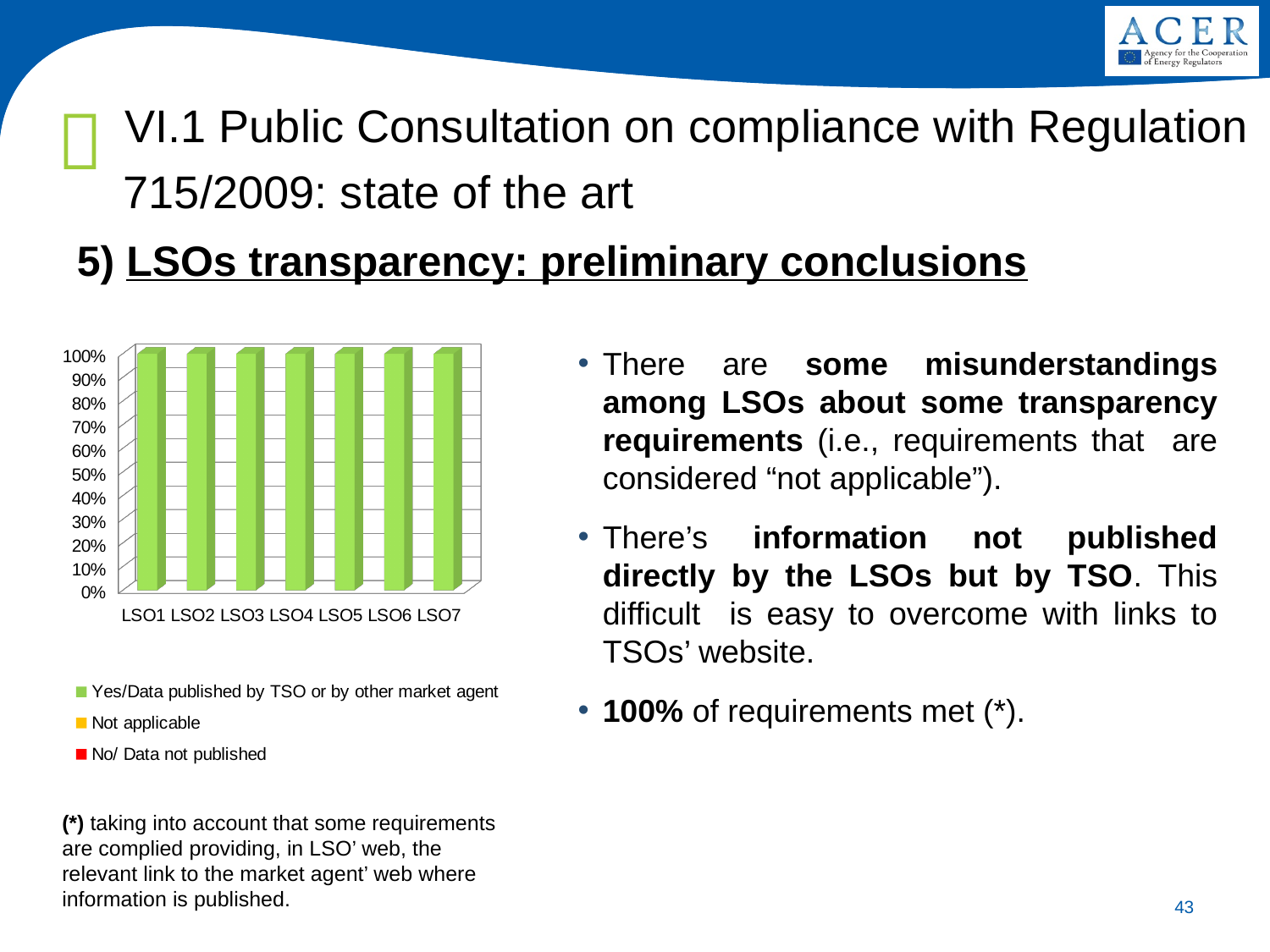
What is the value of the 'Yes/Data published by TSO or by other market agent' series for LSO7? 100% What is the total height of the stacked bar for LSO4? 100% Is the value for LSO6 greater or less than 90%? greater What kind of chart is shown on the slide? bar chart What is the value of the 'Yes/Data published by TSO or by other market agent' series for LSO1? 100% How many series does the chart's legend list? 3 What is the difference between the values for LSO2 and LSO5? 0% Which legend entry is shown in red? No/ Data not published Do the bar values rise, fall, or stay the same from LSO1 to LSO7? stay the same Which legend entry is shown in green? Yes/Data published by TSO or by other market agent Is the value for LSO3 greater or less than 50%? greater How many LSO categories are shown on the x axis of the chart? 7